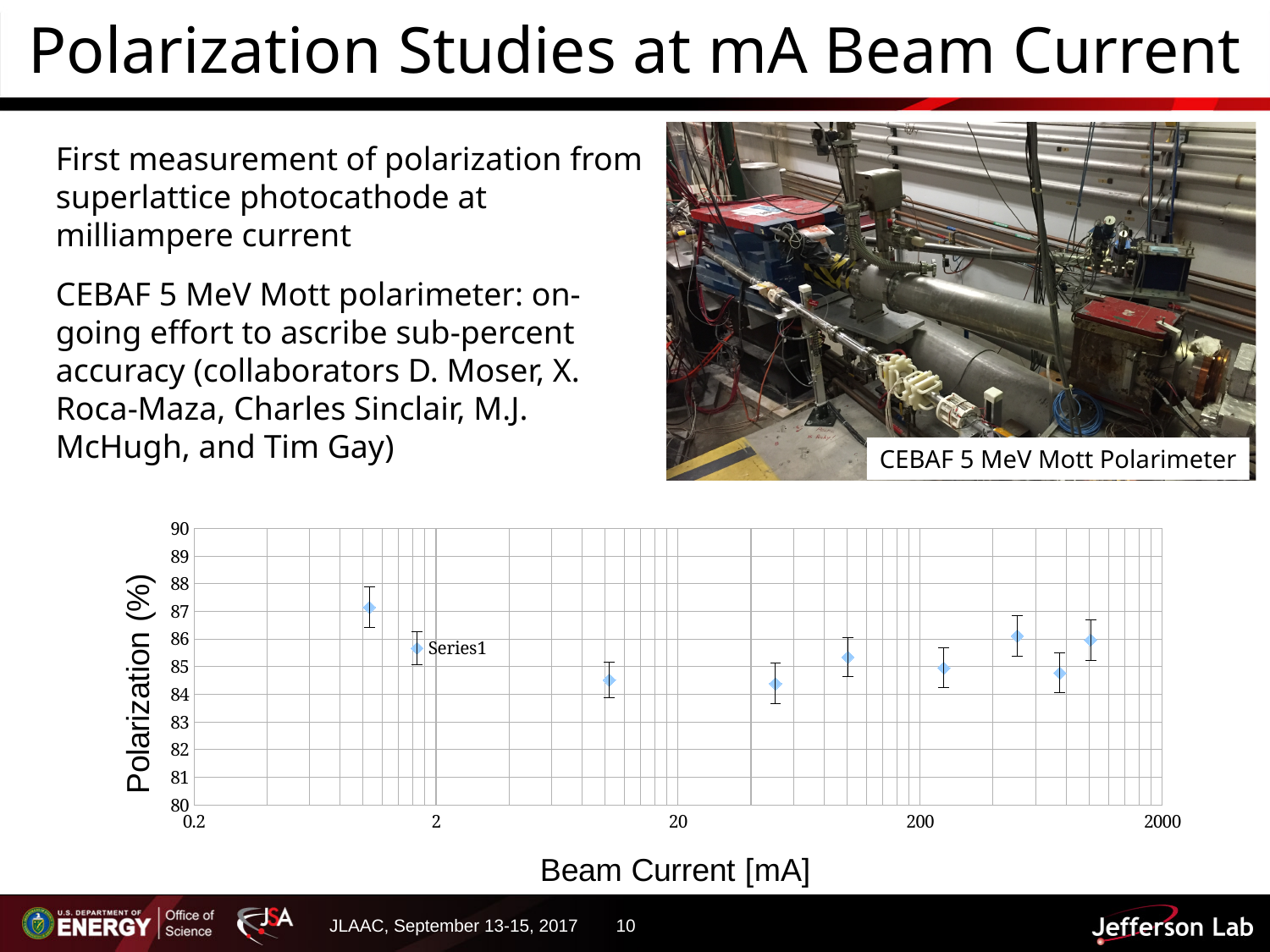
Is the polarization value of the rightmost data point greater or less than 85? greater What is the highest value shown on the y axis of the polarization chart? 90 Is the polarization value of the data point just below 20 mA greater or less than 85? less Is the polarization value of the leftmost data point greater or less than 86? greater How many data points are plotted in the polarization chart? 9 What is the name of the series shown in the polarization chart legend? Series1 Which data point has the highest polarization in the chart? The leftmost point (at about 1 mA) What is the x-axis title of the polarization chart? Beam Current [mA] Which has the higher polarization: the leftmost data point or the rightmost data point? The leftmost data point Does the polarization rise or fall from the first data point to the second data point along the x axis? Fall How many series does the legend of the polarization chart list? 1 What kind of chart is shown at the bottom of the slide? Scatter chart